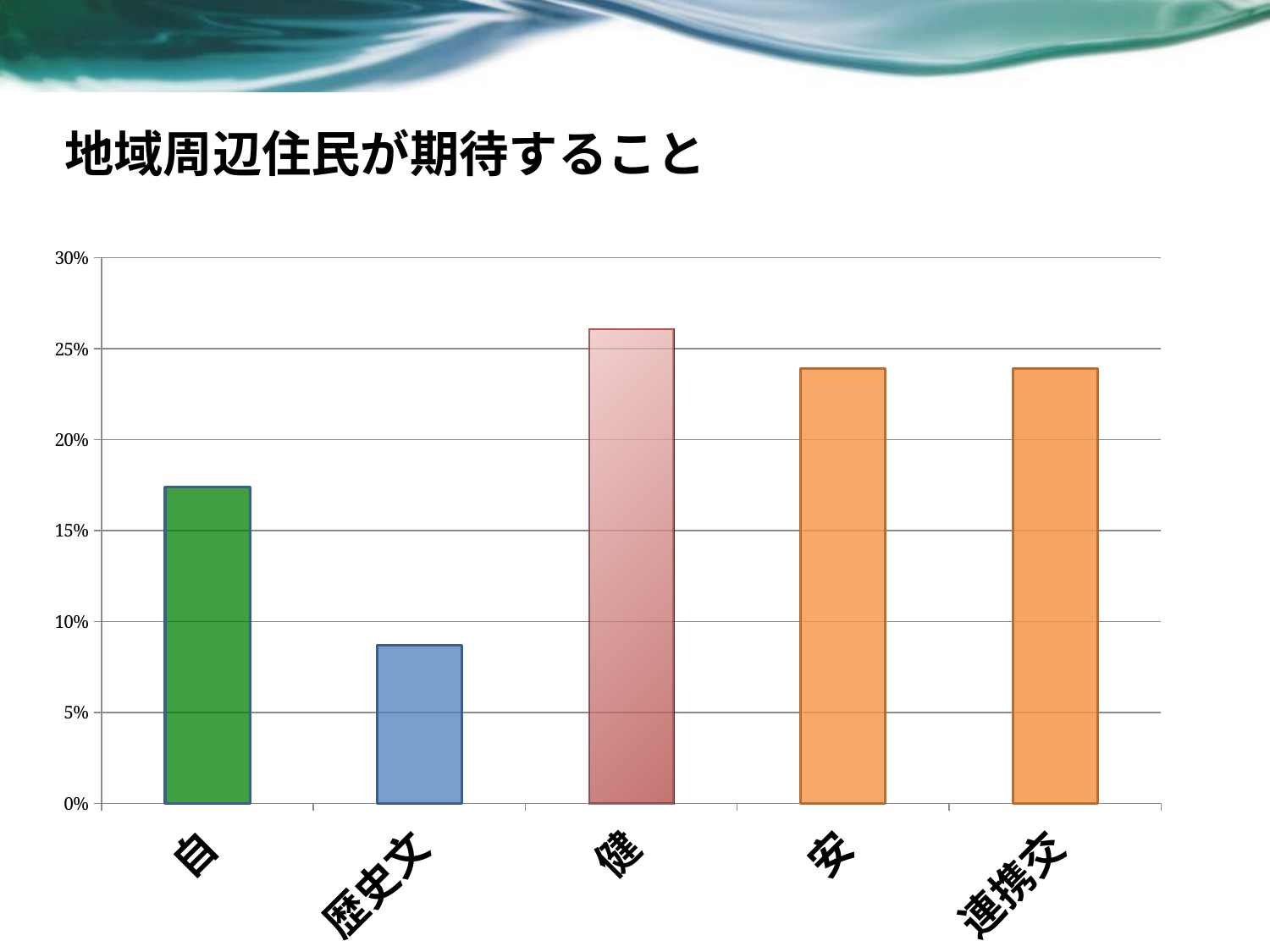
How many bars are plotted in the chart? 5 What kind of chart is shown on the slide? bar chart Is the value for 自 greater or less than 15%? greater What is the title of the slide? 地域周辺住民が期待すること Is the value for 安 greater or less than 25%? less Which category has the highest bar? 健 Which is larger, the value for 健 or the value for 安? 健 Is the value for 歴史文 greater or less than 10%? less Which category has the lowest bar? 歴史文 Which is larger, the value for 自 or the value for 歴史文? 自